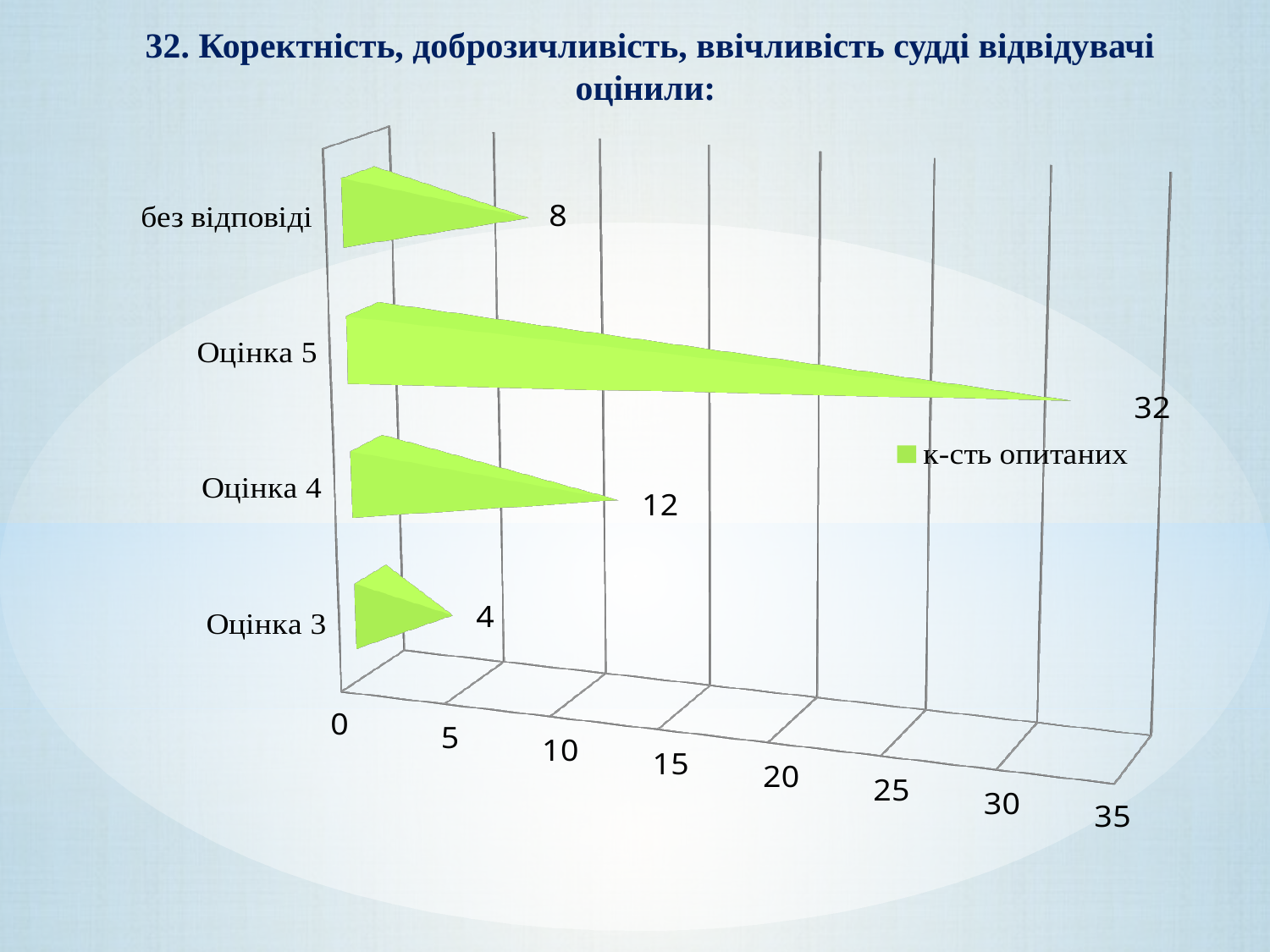
Is the value for Оцінка 5 greater or less than 30? greater What is the legend entry for the series? к-сть опитаних What is the value for без відповіді? 8 How many categories are shown in the chart? 4 What is the value for Оцінка 3? 4 Which category has the lowest value? Оцінка 3 What is the difference between the values for Оцінка 5 and Оцінка 4? 20 Which category has the highest value? Оцінка 5 Which is larger, the value for Оцінка 4 or the value for без відповіді? Оцінка 4 How many series does the legend list? 1 What is the value for Оцінка 5? 32 What kind of chart is shown on the slide? bar chart